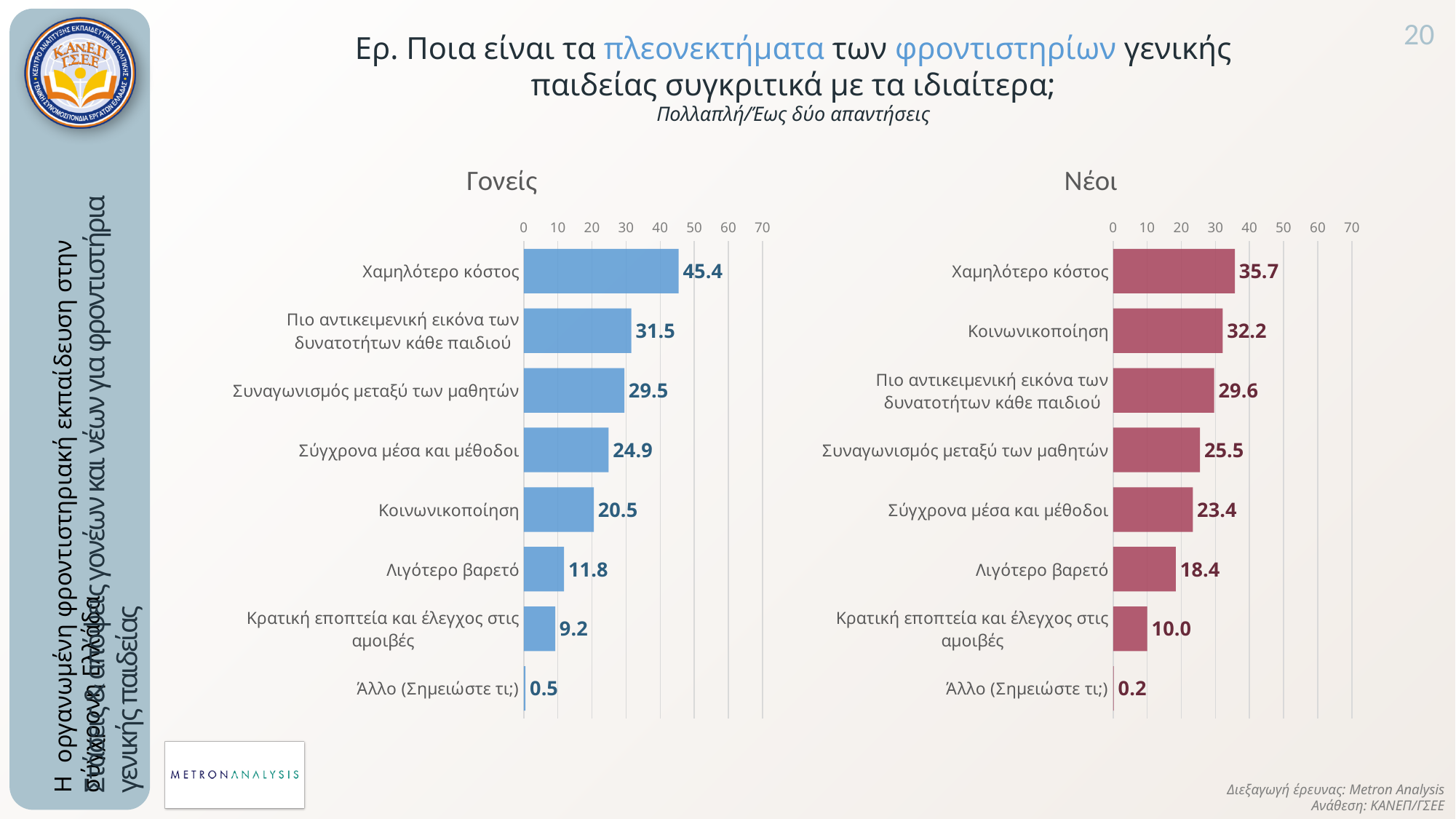
In the Γονείς chart, is the value for Πιο αντικειμενική εικόνα των δυνατοτήτων κάθε παιδιού greater or less than 30? greater What is the difference between the Γονείς and Νέοι values for Χαμηλότερο κόστος? 9.7 In the Νέοι chart, what is the value for Κοινωνικοποίηση? 32.2 In the Γονείς chart, what is the difference between Συναγωνισμός μεταξύ των μαθητών and Σύγχρονα μέσα και μέθοδοι? 4.6 In the Νέοι chart, what is the value for Λιγότερο βαρετό? 18.4 What colour are the bars in the Νέοι chart? Red In the Νέοι chart, which category has the lowest value? Άλλο (Σημειώστε τι;) In the Γονείς chart, which category has the highest value? Χαμηλότερο κόστος What type of chart is used for the Γονείς data? Bar chart Which is larger: the Γονείς value for Κοινωνικοποίηση or the Νέοι value for Κοινωνικοποίηση? Νέοι How many categories are shown in the Νέοι chart? 8 In the Γονείς chart, what is the value for Χαμηλότερο κόστος? 45.4